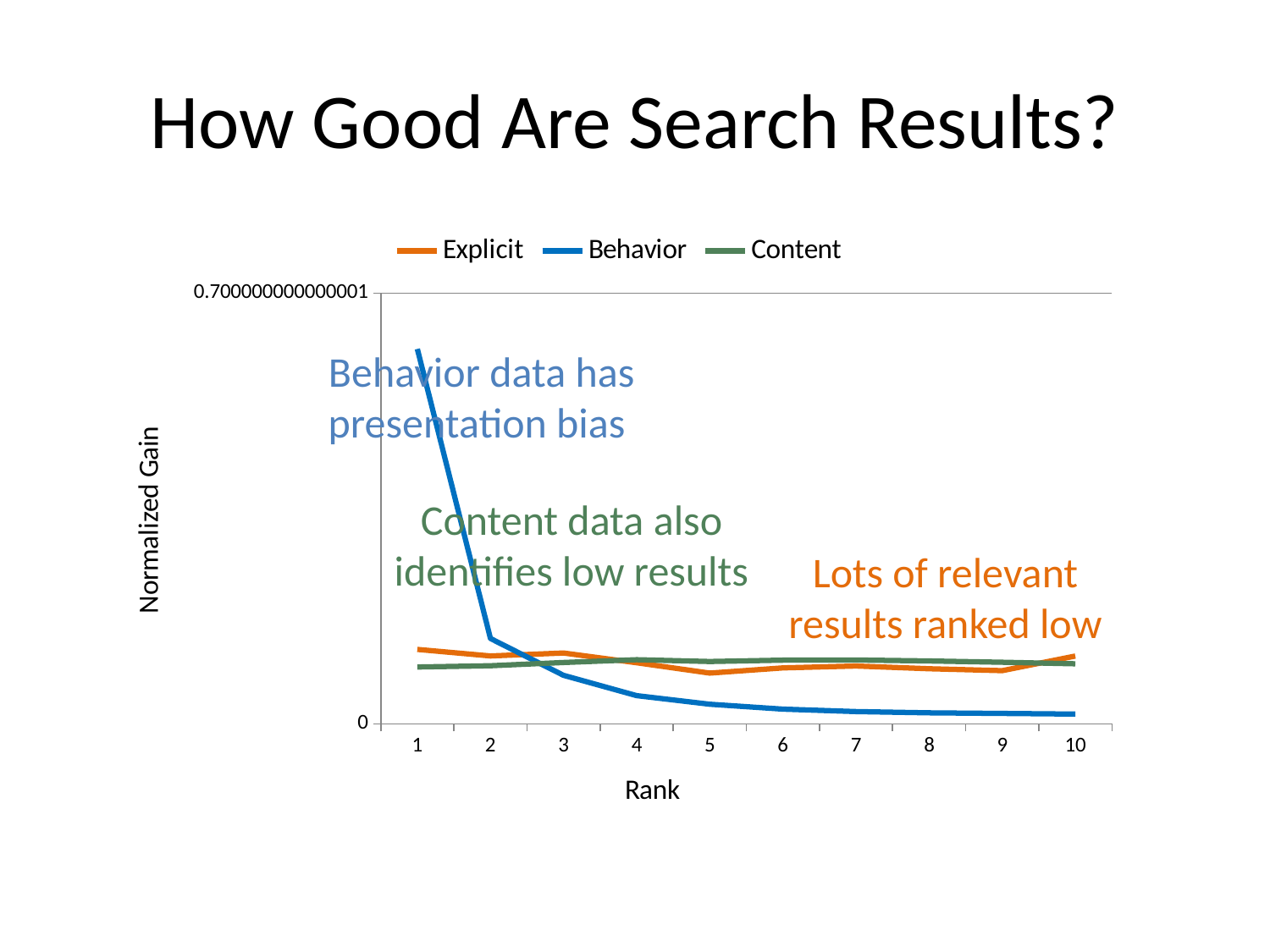
Does the Behavior series rise or fall as rank increases from 1 to 10? fall Which series has the highest value at rank 1? Behavior At rank 8, which is larger: the Content value or the Behavior value? Content How many series does the legend list? 3 Is the value for Behavior at rank 1 greater or less than 0.7? less What kind of chart is shown on the slide? line chart Which series has the lowest value at rank 10? Behavior What is the title of the chart's x axis? Rank At rank 1, which is larger: the Behavior value or the Explicit value? Behavior What is the title of the chart's y axis? Normalized Gain How many rank positions are plotted along the x axis? 10